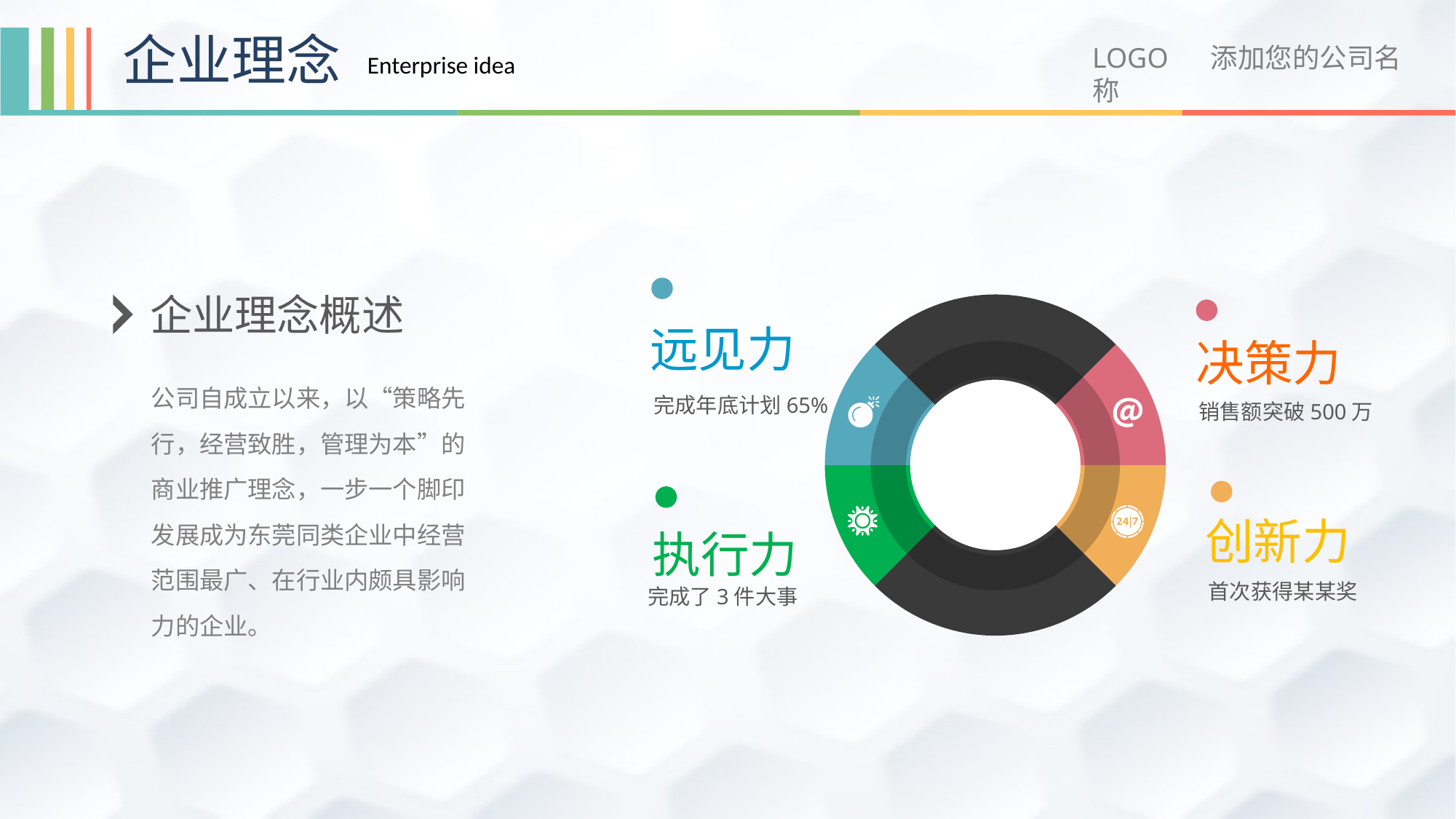
What colour is the segment labelled 远见力? Blue What kind of chart is shown on the right of the slide? Donut (ring) chart What colour is the segment labelled 执行力? Green What sales figure is printed under 决策力? 500 万 What percentage is printed under 远见力? 65% How many coloured segments does the ring diagram have? 4 How many 大事 (major things) are stated as completed under 执行力? 3